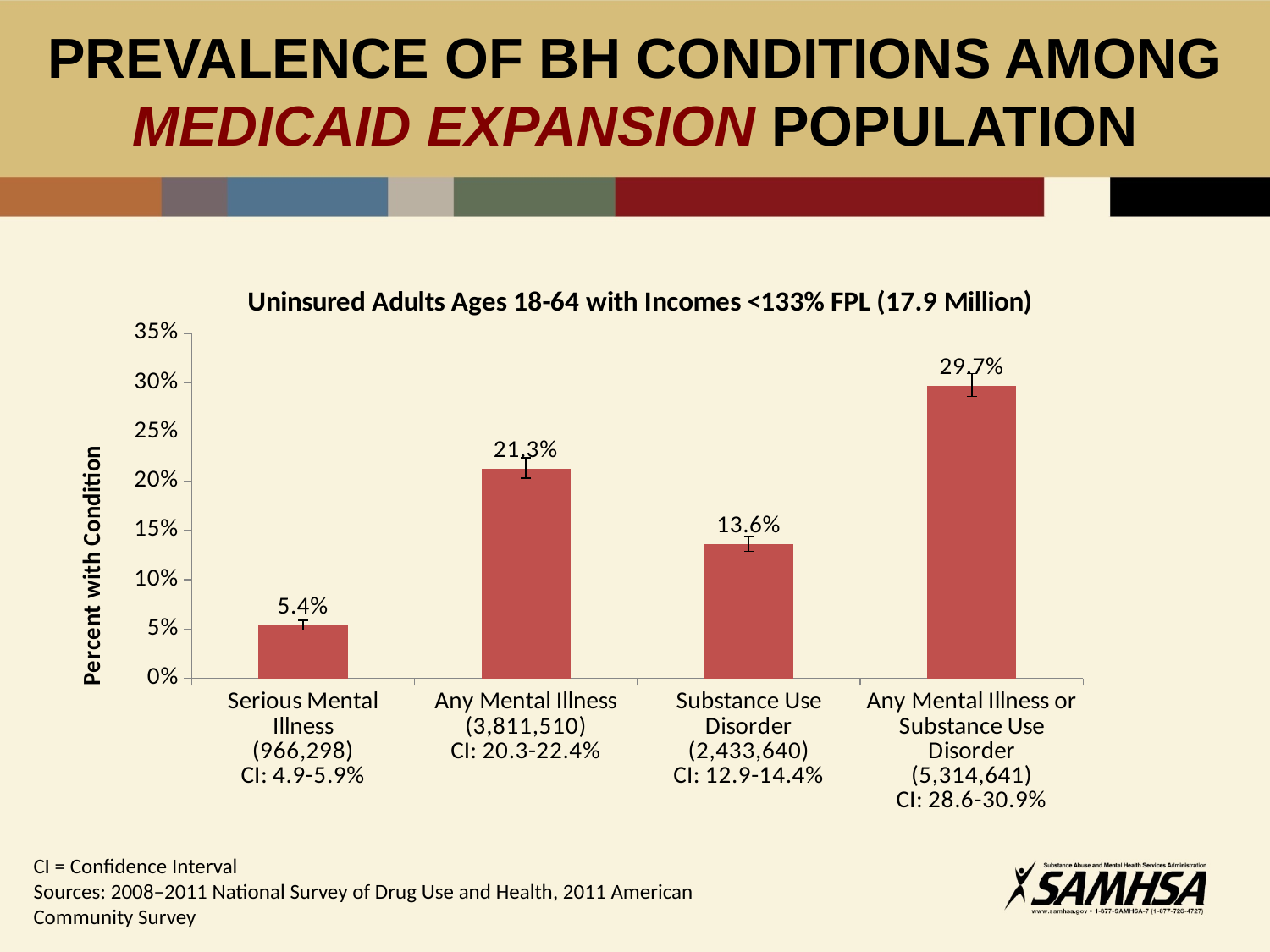
Which category has the highest value? Any Mental Illness or Substance Use Disorder What is the value for Serious Mental Illness? 5.4% What is the value for Substance Use Disorder? 13.6% Which is larger, the value for Any Mental Illness or the value for Substance Use Disorder? Any Mental Illness What is the title of the chart? Uninsured Adults Ages 18-64 with Incomes <133% FPL (17.9 Million) How many categories are shown on the x axis? 4 What kind of chart is shown on the slide? bar chart What is the value for Any Mental Illness? 21.3% Is the value for Any Mental Illness or Substance Use Disorder greater or less than 25%? greater Which category has the lowest value? Serious Mental Illness What is the difference between the values for Any Mental Illness and Substance Use Disorder? 7.7% What is the value for Any Mental Illness or Substance Use Disorder? 29.7%